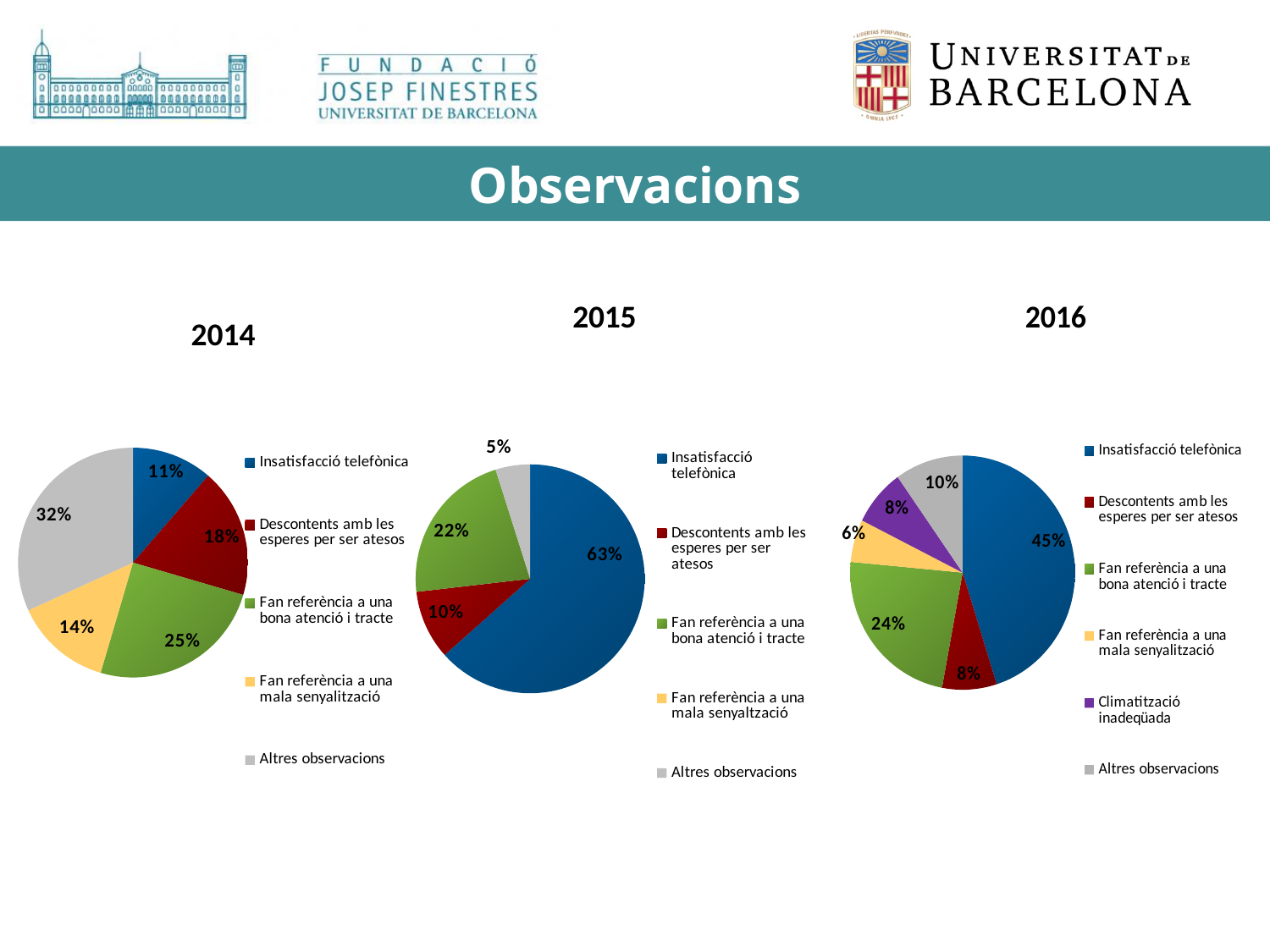
In the 2014 pie chart, what share is labelled for Altres observacions? 32% What is the difference between the Insatisfacció telefònica share in 2015 and in 2014? 52% What type of chart is used for the 2014 data? Pie chart In the 2015 pie chart, what share is labelled for Insatisfacció telefònica? 63% How many categories does the legend of the 2016 pie chart list? 6 In the 2015 pie chart, what is the difference between the shares for Fan referència a una bona atenció i tracte and Descontents amb les esperes per ser atesos? 12% In the 2014 pie chart, which category has the smallest share? Insatisfacció telefònica In the 2014 pie chart, what percentage corresponds to Fan referència a una bona atenció i tracte? 25% In the 2015 pie chart, which category has the largest share? Insatisfacció telefònica In the 2016 pie chart, what share is labelled for Climatització inadeqüada? 8% In the 2016 pie chart, what percentage corresponds to Fan referència a una bona atenció i tracte? 24% In the 2016 pie chart, which is larger: Altres observacions or Fan referència a una mala senyalització? Altres observacions